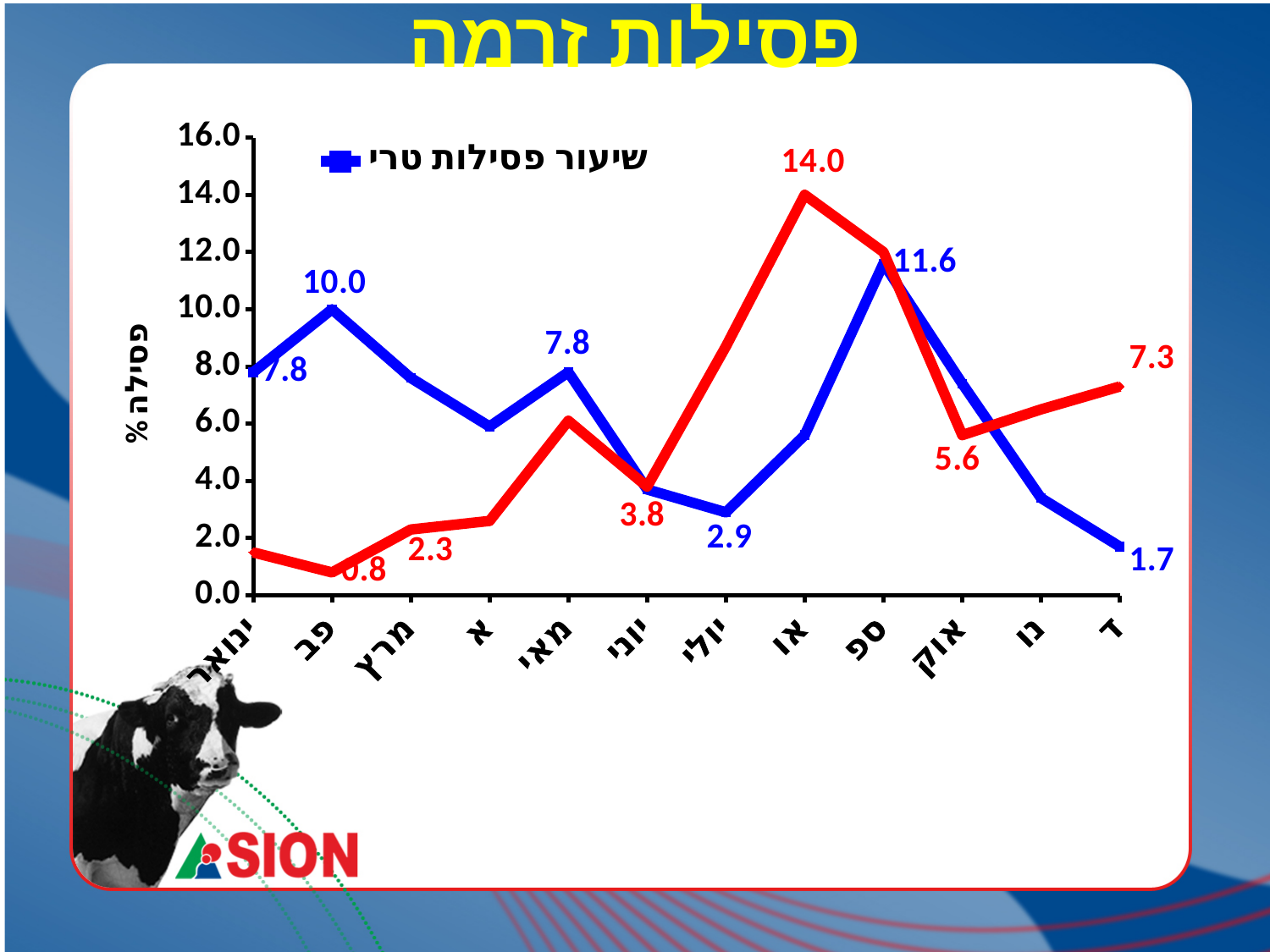
In which month does the red line reach its highest value? או What is the value of the blue line (שיעור פסילות טרי) in ד? 1.7 What is the value of the blue line (שיעור פסילות טרי) in פב? 10.0 What is the value of the red line in או? 14.0 In which month does the blue line (שיעור פסילות טרי) reach its lowest value? ד What type of chart is shown on the slide? line chart In ד, which line has the larger value, the red line or the blue line? the red line Is the value of the blue line in נו greater or less than 4.0? less How many series does the legend list? 1 Does the blue line rise or fall from ספ to ד? fall How many months are shown along the x axis? 12 What is the difference between the blue line's value in פב (10.0) and in ינואר (7.8)? 2.2